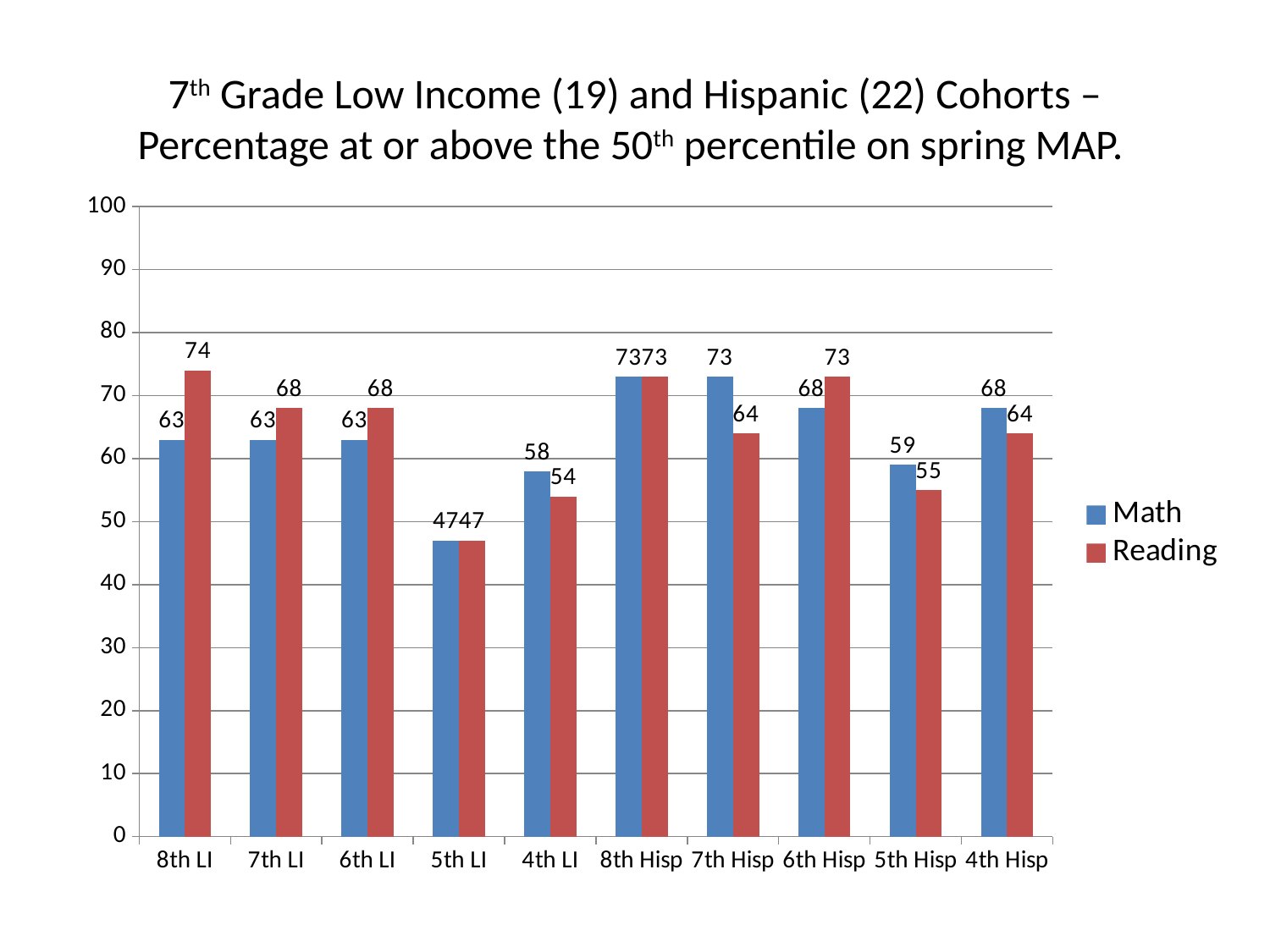
What is the difference between the Reading and Math values for 7th Hisp? 9 What kind of chart is shown on the slide? Bar chart How many categories are shown on the x axis? 10 Which colour represents the Reading series? Red What is the Reading value for 8th LI? 74 Which category has the highest Reading value? 8th LI What is the Math value for 4th LI? 58 Which category has the lowest Math value? 5th LI How many series does the legend list? 2 What is the Math value for 8th LI? 63 Which is larger for 6th Hisp, the Math value or the Reading value? Reading What is the Reading value for 5th Hisp? 55